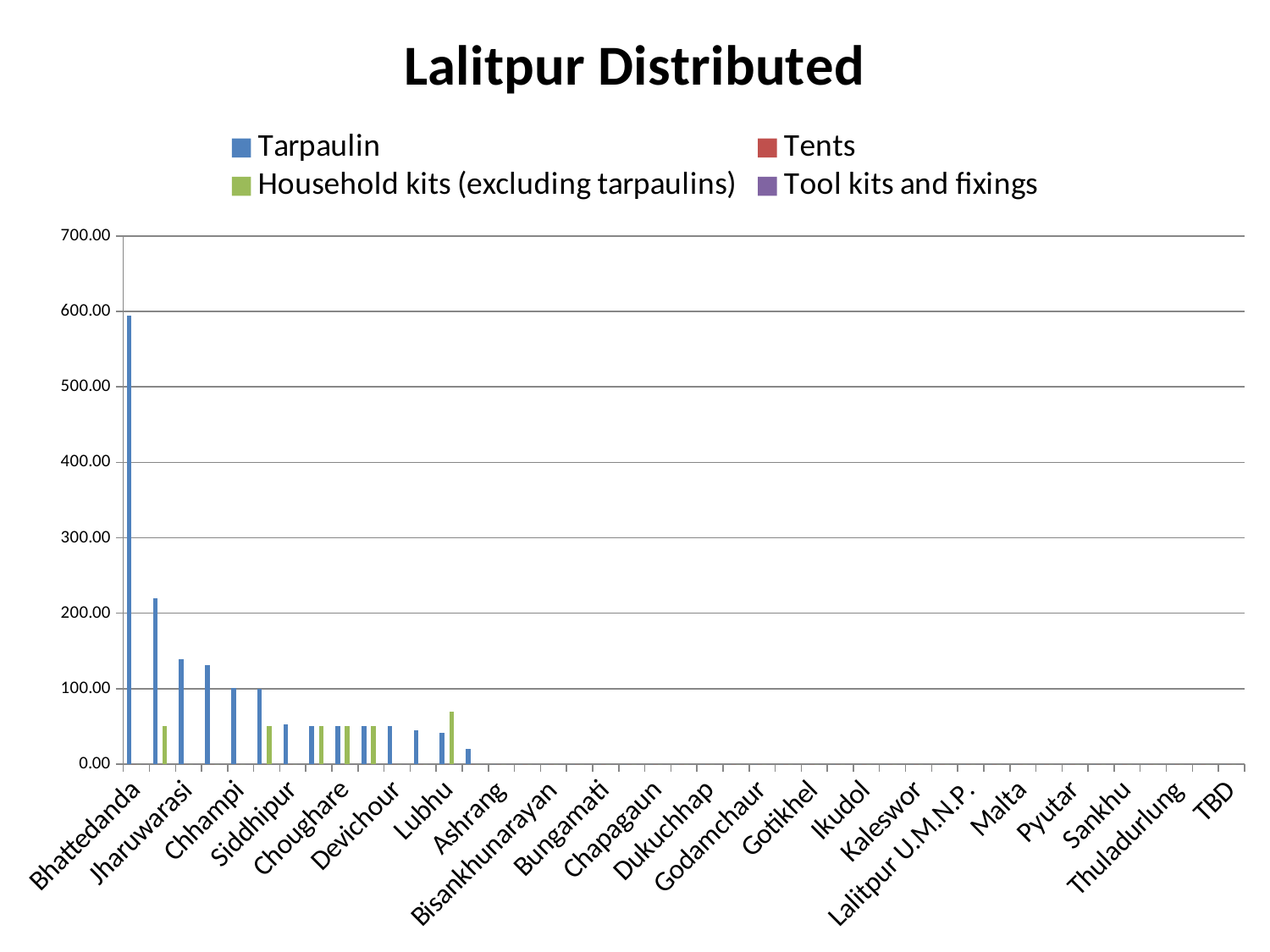
Which has the larger Tarpaulin value, Bhattedanda or Jharuwarasi? Bhattedanda At Lubhu, which is larger: the Tarpaulin bar or the Household kits (excluding tarpaulins) bar? Household kits (excluding tarpaulins) What kind of chart is shown on the slide? bar chart How many series does the legend list? 4 Which category has the highest Tarpaulin value? Bhattedanda Is the Tarpaulin value for Bhattedanda greater or less than 500.00? greater What is the title of the chart? Lalitpur Distributed Do the Tarpaulin values generally rise or fall moving from left to right along the x axis? fall Is the Tarpaulin value for Jharuwarasi greater or less than 200.00? less What colour represents Tarpaulin in the legend? blue Is the Tarpaulin value for Jharuwarasi greater or less than 100.00? greater